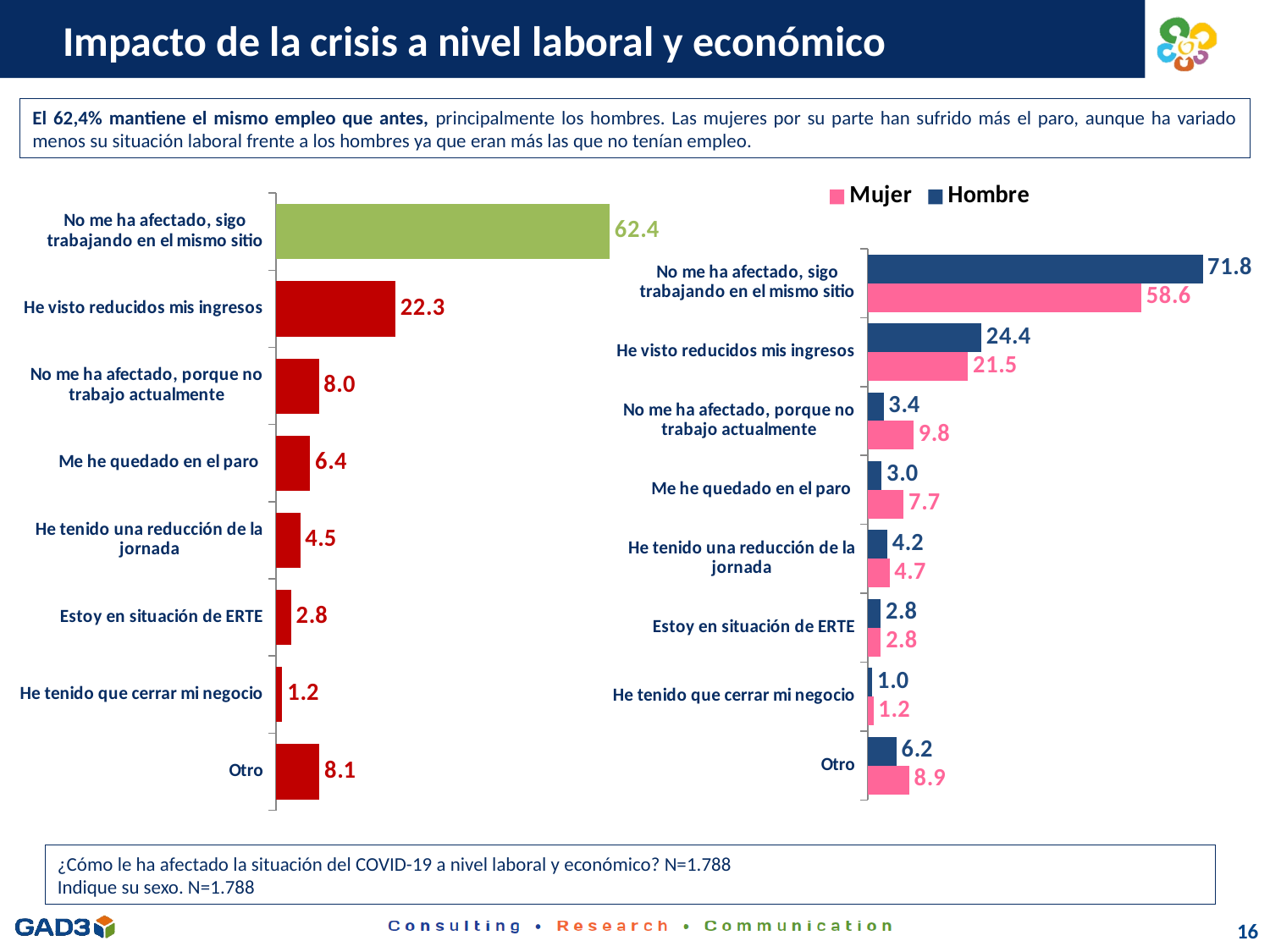
In the right chart, which is larger for "No me ha afectado, porque no trabajo actualmente": Mujer or Hombre? Mujer In the right chart, what is the Mujer value for "Me he quedado en el paro"? 7.7 In the left chart, what is the difference between "Otro" and "Me he quedado en el paro"? 1.7 In the left chart, which category has the lowest value? He tenido que cerrar mi negocio In the right chart, how many series does the legend list? 2 In the right chart, what is the Hombre value for "No me ha afectado, sigo trabajando en el mismo sitio"? 71.8 In the left chart, which category has the highest value? No me ha afectado, sigo trabajando en el mismo sitio In the left chart, how many categories are shown? 8 What kind of chart is the right chart? Bar chart In the right chart, which colour represents the Mujer series? Pink In the right chart, what is the difference between the Hombre and Mujer values for "He visto reducidos mis ingresos"? 2.9 In the left chart, what is the value for "He visto reducidos mis ingresos"? 22.3